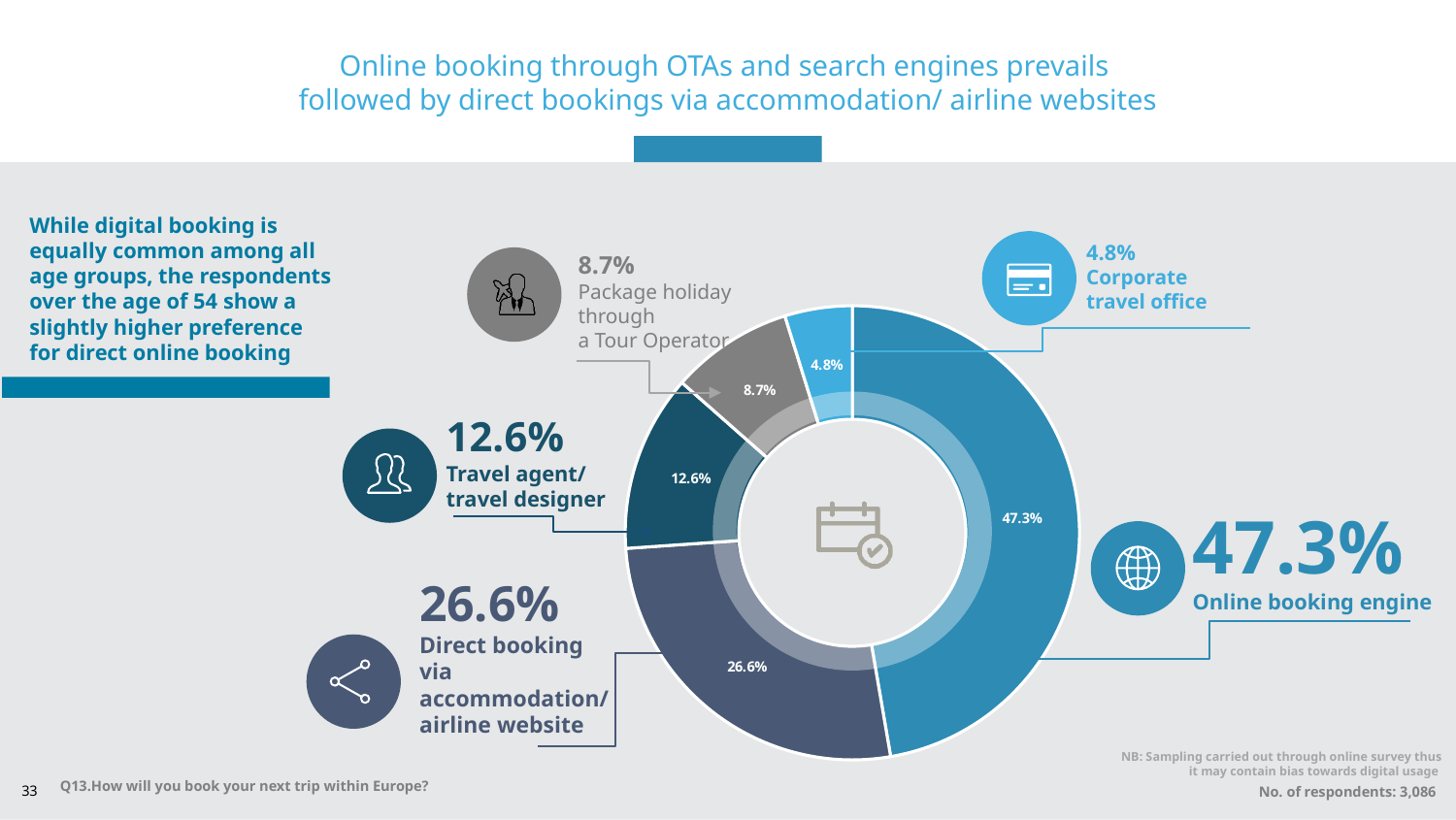
Which booking method has the largest share in the chart? Online booking engine How many percentage points higher is online booking engine than direct booking via accommodation/airline website? 20.7 Which is larger: the share for package holiday through a tour operator or the share for corporate travel office? Package holiday through a tour operator What share of respondents will book their next trip within Europe through an online booking engine? 47.3% What is the value shown for travel agent/travel designer? 12.6% What type of chart is used on this slide? Donut (pie) chart How many booking methods are shown in the chart? 5 What is the difference between the travel agent/travel designer share and the corporate travel office share? 7.8 What is the combined share of online booking engine and direct booking via accommodation/airline website? 73.9% What percentage of respondents plan to book directly via an accommodation/airline website? 26.6% What percentage of respondents will book a package holiday through a tour operator? 8.7% Which booking method has the smallest share in the chart? Corporate travel office